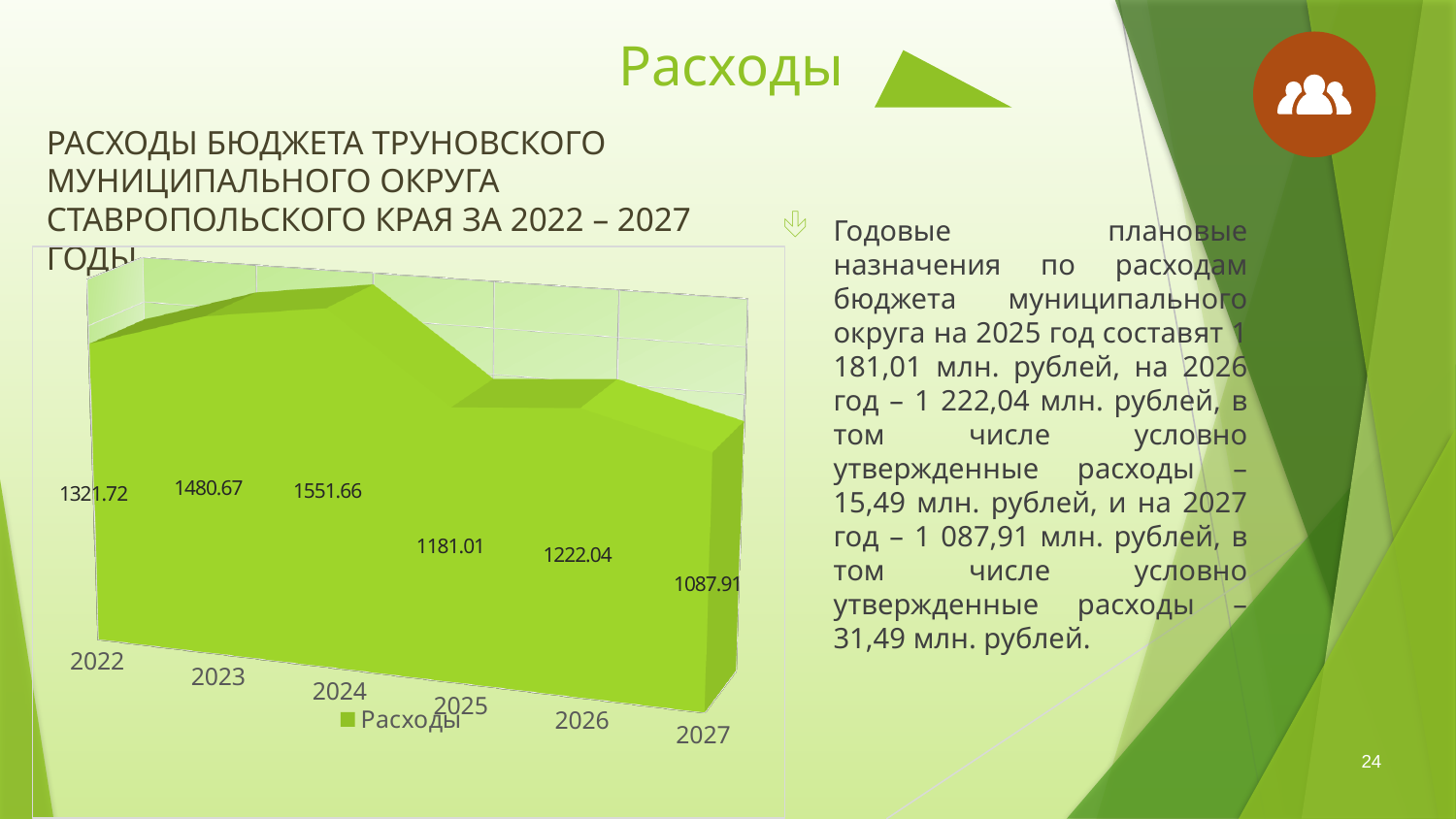
What is the value for 2027 in the chart? 1087.91 What is the value for 2022 in the chart? 1321.72 What type of chart is shown on the slide? Area chart Which year has the highest value in the chart? 2024 What is the value for 2024 in the chart? 1551.66 How many years are shown on the x axis of the chart? 6 What is the difference between the values for 2023 and 2022? 158.95 Which is larger, the value for 2025 or the value for 2026? 2026 What is the difference between the values for 2024 and 2025? 370.65 Which year has the lowest value in the chart? 2027 How many series does the chart legend list? 1 What is the name of the series shown in the chart legend? Расходы